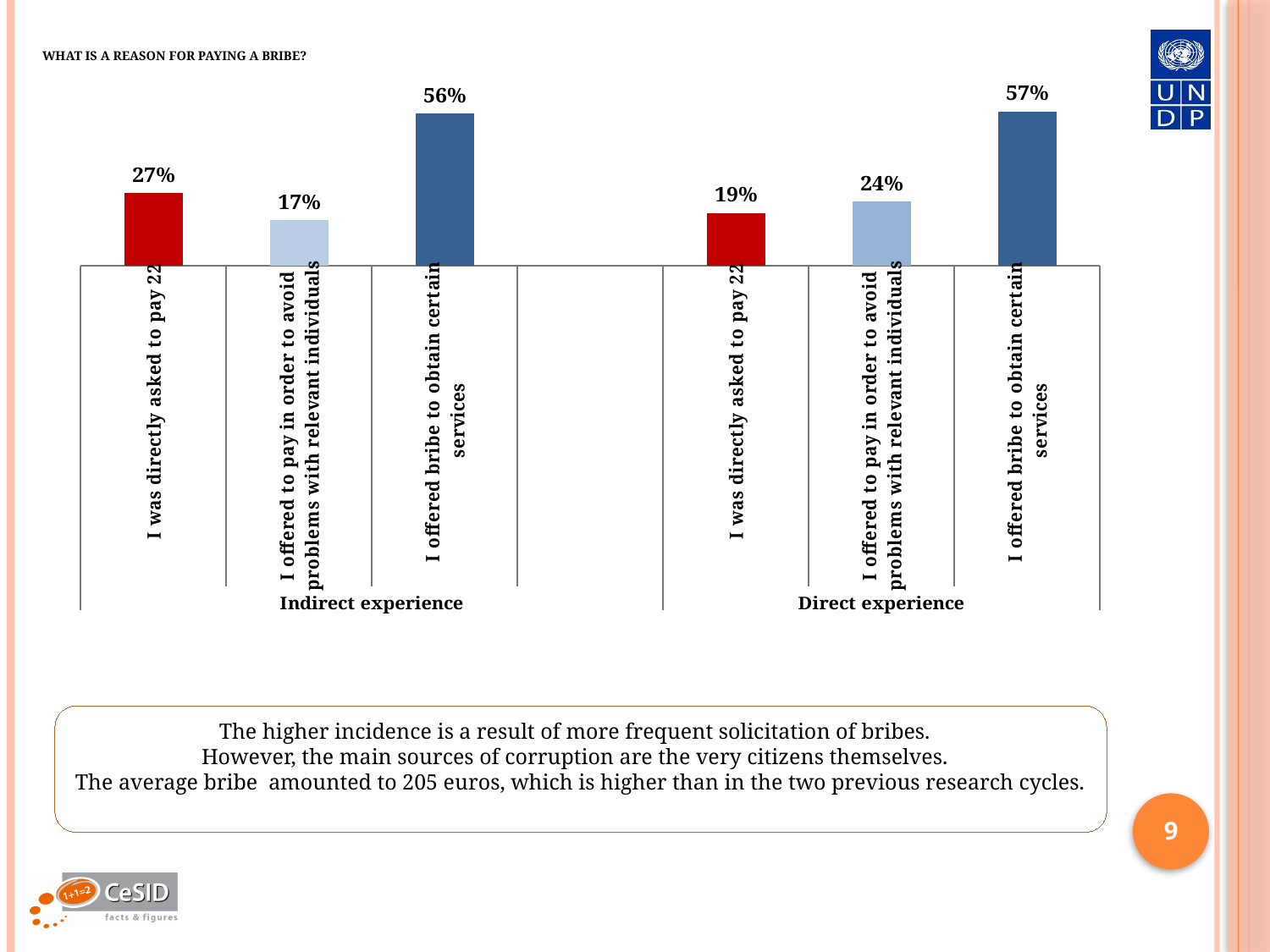
What is the title of the chart? What is a reason for paying a bribe? What is the value for "I offered bribe to obtain certain services" under Direct experience? 57% What is the difference between the Indirect experience and Direct experience values for "I was directly asked to pay"? 8% What is the value for "I offered bribe to obtain certain services" under Indirect experience? 56% What is the value for "I offered to pay in order to avoid problems with relevant individuals" under Indirect experience? 17% What kind of chart is shown on the slide? Bar chart What is the value for "I offered to pay in order to avoid problems with relevant individuals" under Direct experience? 24% Which reason has the highest value under Indirect experience? I offered bribe to obtain certain services Which reason has the lowest value under Direct experience? I was directly asked to pay Which is larger: the Indirect experience value for "I was directly asked to pay" or the Direct experience value for "I offered to pay in order to avoid problems with relevant individuals"? Indirect experience value for "I was directly asked to pay" (27%) How many bars are plotted in the chart in total? 6 What is the difference between the two "I offered to pay in order to avoid problems with relevant individuals" values (Direct minus Indirect)? 7%